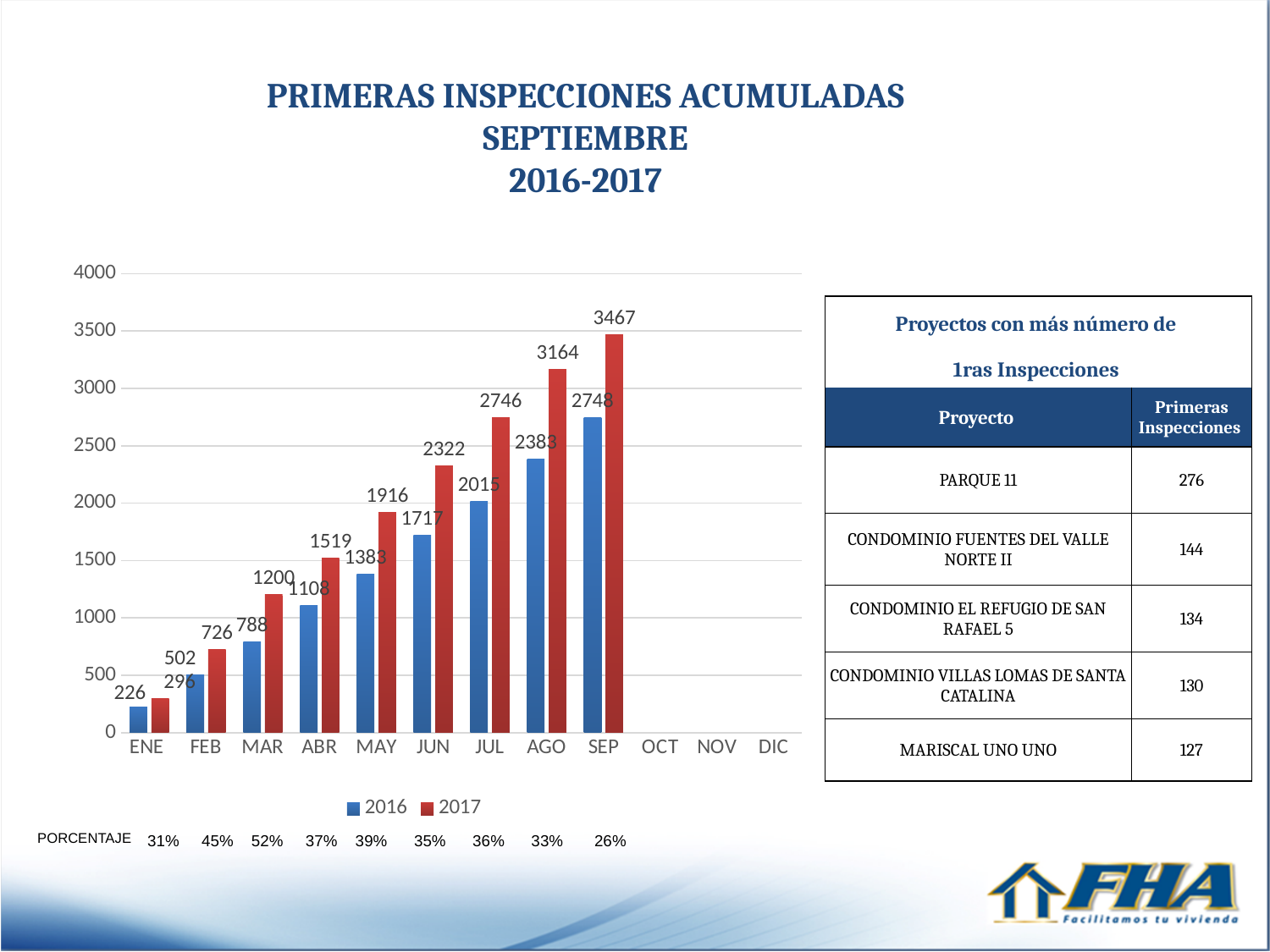
What is the difference between the 2017 and 2016 values for SEP? 719 What is the difference between the 2017 values for AGO and JUL? 418 How many series does the legend list? 2 Is the 2016 value for JUN greater or less than 1500? greater What kind of chart is shown on the slide? bar chart What is the value of the 2016 bar for AGO? 2383 Which month has the lowest 2016 value? ENE What is the value of the 2017 bar for SEP? 3467 Which month has the highest 2017 value? SEP Which is larger: the 2017 value for JUL or the 2016 value for AGO? 2017 value for JUL What is the value of the 2017 bar for MAY? 1916 How many month categories are shown on the x axis? 12